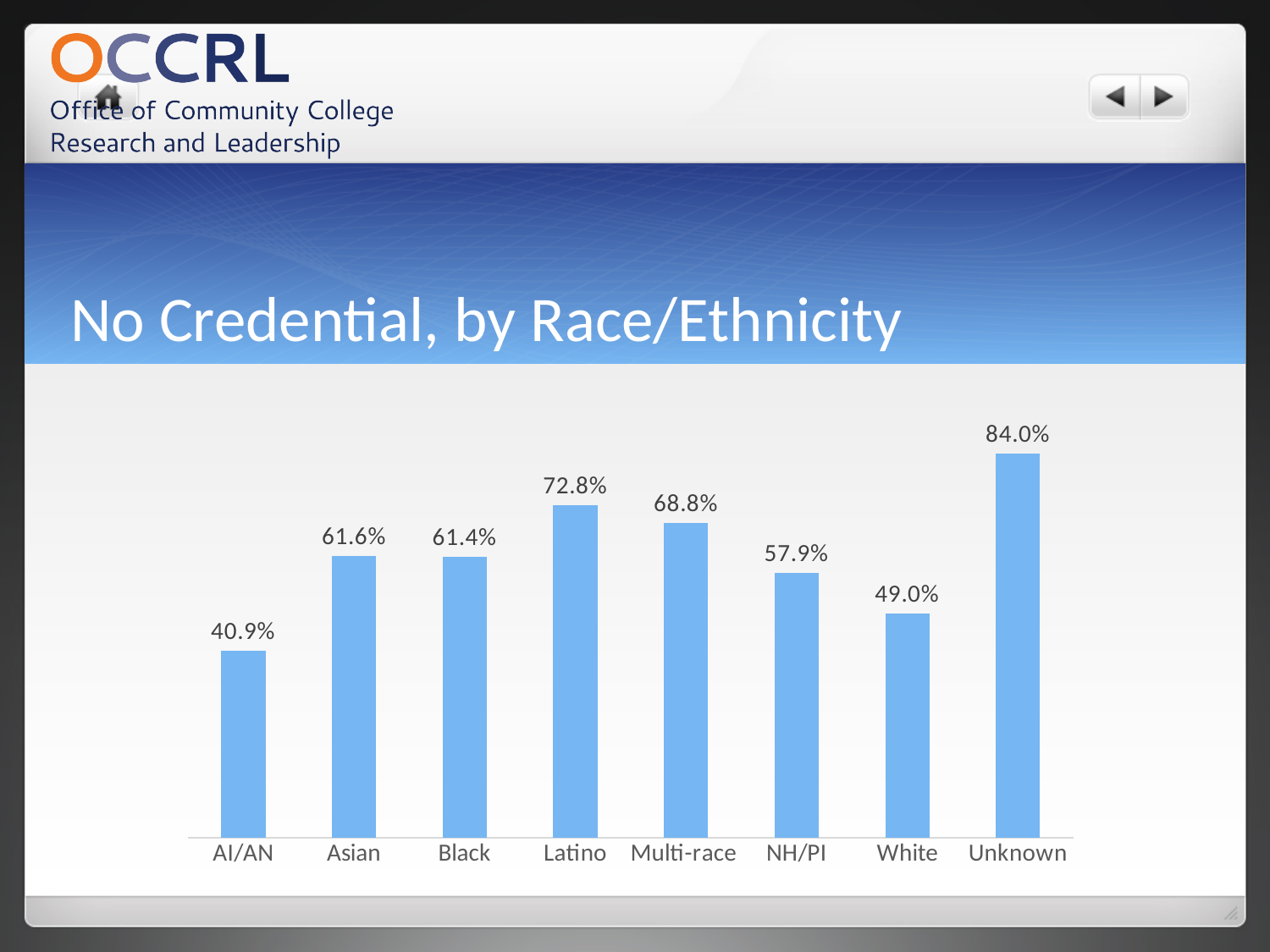
Which category has the highest value? Unknown What is the value for NH/PI? 57.9% What colour are the bars in the chart? light blue What is the value for Latino? 72.8% What is the value for White? 49.0% What is the difference between the values for Latino and Multi-race? 4.0% What is the difference between the values for Unknown and AI/AN? 43.1% How many categories are shown on the x axis? 8 Which is larger, the value for Multi-race or the value for NH/PI? Multi-race What kind of chart is shown on the slide? bar chart What is the title of the slide? No Credential, by Race/Ethnicity Which category has the lowest value? AI/AN